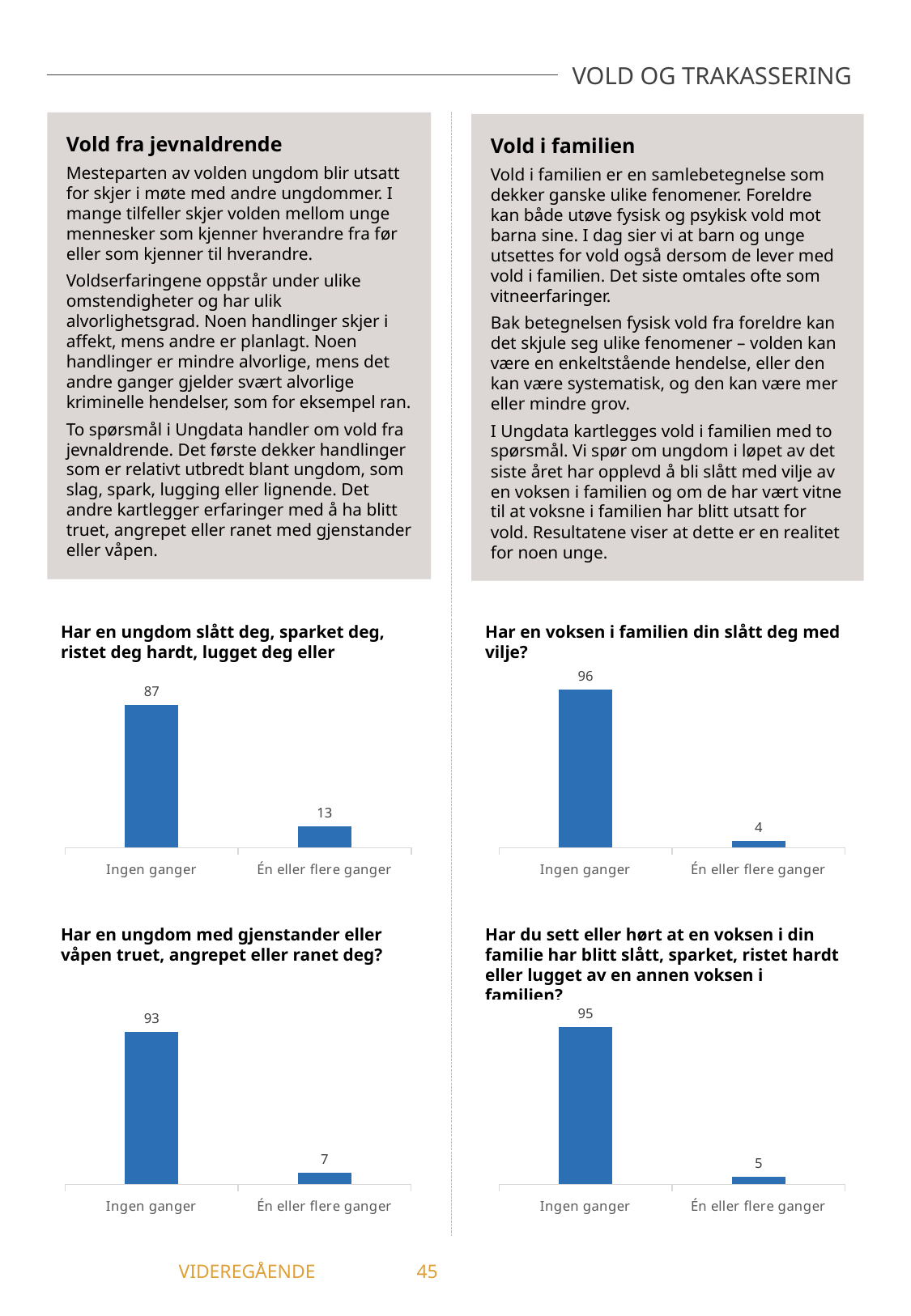
In the bottom-right chart ("Har du sett eller hørt at en voksen i din familie har blitt slått..."), what is the value for "Ingen ganger"? 95 In the top-right chart ("Har en voksen i familien din slått deg med vilje?"), which category has the highest value? Ingen ganger In the bottom-right chart ("Har du sett eller hørt at en voksen i din familie har blitt slått..."), which category has the lowest value? Én eller flere ganger In the bottom-left chart ("Har en ungdom med gjenstander eller våpen truet, angrepet eller ranet deg?"), what is the value for "Én eller flere ganger"? 7 In the top-left chart ("Har en ungdom slått deg, sparket deg..."), which is larger: "Ingen ganger" or "Én eller flere ganger"? Ingen ganger In the top-left chart ("Har en ungdom slått deg, sparket deg..."), what is the value for "Ingen ganger"? 87 In the bottom-left chart ("Har en ungdom med gjenstander eller våpen truet, angrepet eller ranet deg?"), what is the difference between "Ingen ganger" and "Én eller flere ganger"? 86 In the top-right chart ("Har en voksen i familien din slått deg med vilje?"), what is the value for "Én eller flere ganger"? 4 What kind of chart is the top-right chart ("Har en voksen i familien din slått deg med vilje?")? Bar chart In the top-left chart ("Har en ungdom slått deg, sparket deg..."), what is the value for "Én eller flere ganger"? 13 How many categories does the bottom-left chart ("Har en ungdom med gjenstander eller våpen truet, angrepet eller ranet deg?") show? 2 In the top-right chart ("Har en voksen i familien din slått deg med vilje?"), what is the value for "Ingen ganger"? 96